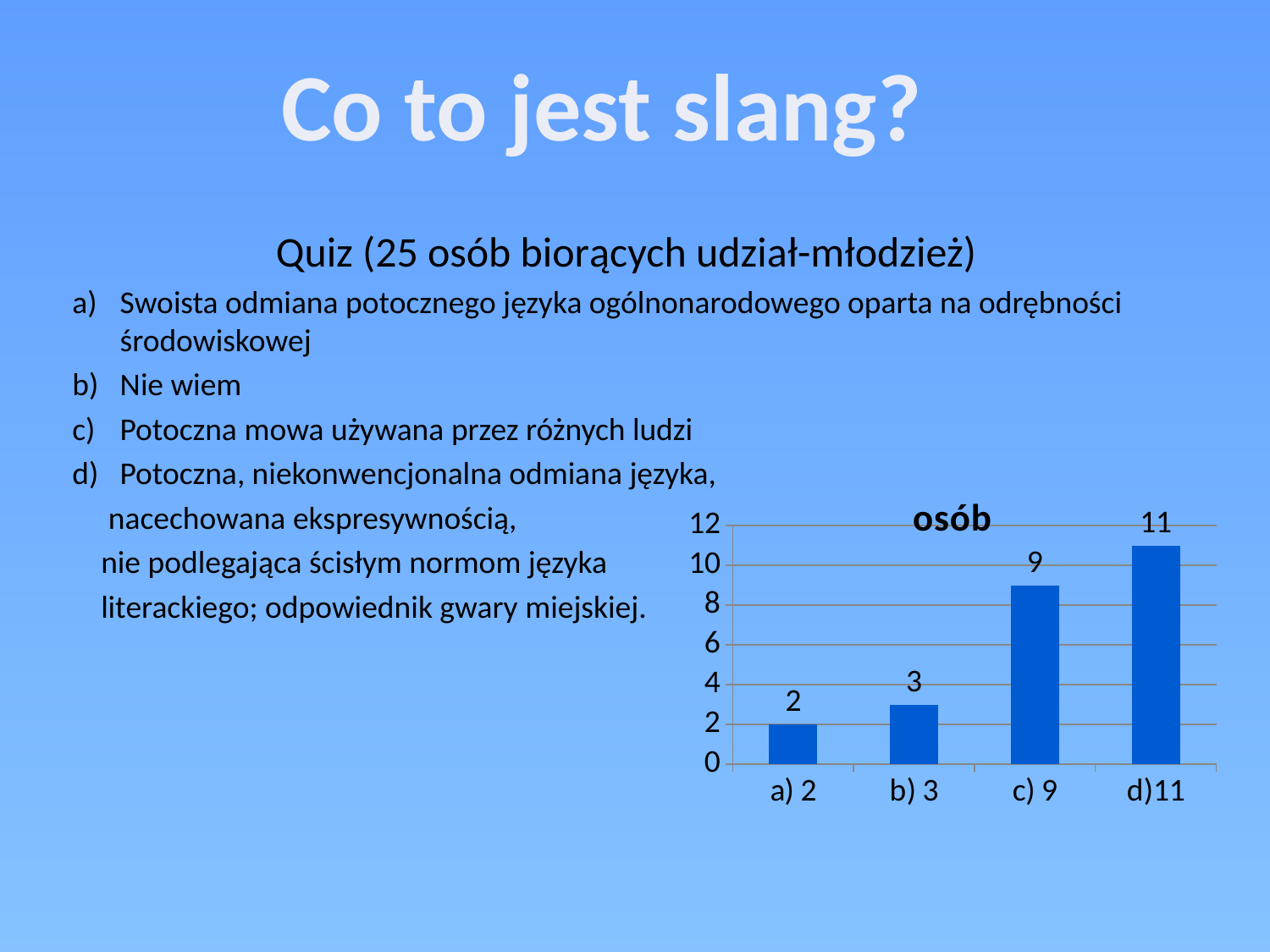
Which category has the lowest value? a) 2 Which category has the highest value? d)11 What is the value for category "c) 9"? 9 Which is larger, the value for "b) 3" or the value for "c) 9"? c) 9 What is the difference between the values for "c) 9" and "b) 3"? 6 How many categories are shown on the x axis? 4 What is the value for category "d)11"? 11 Do the values rise or fall from left to right along the x axis? rise What kind of chart is shown on the slide? bar chart What is the difference between the values for "d)11" and "c) 9"? 2 What is the value for category "a) 2"? 2 What is the title of the chart? osób